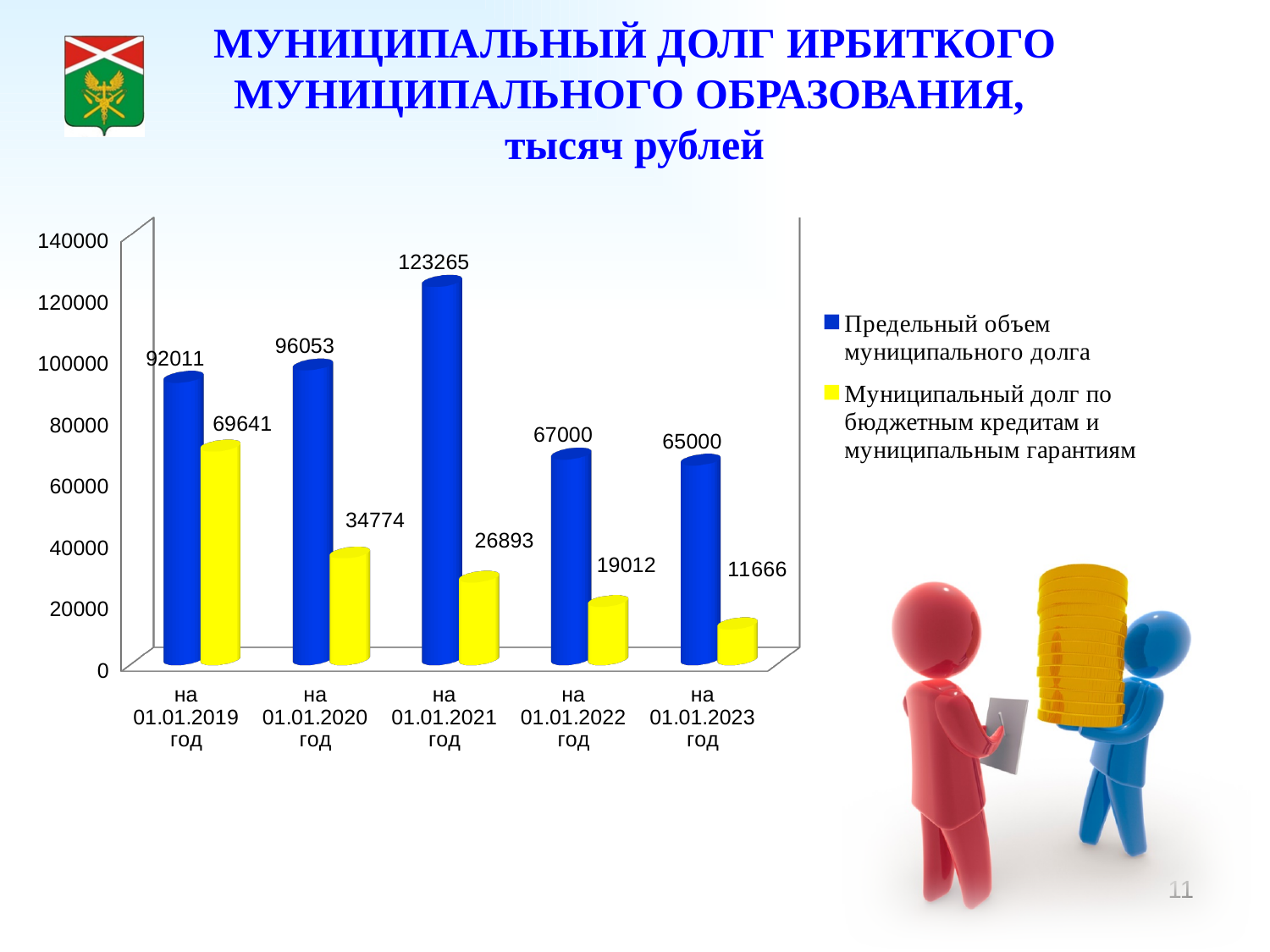
How many dates (categories) are shown on the x axis of the chart? 5 What is the value of «Муниципальный долг по бюджетным кредитам и муниципальным гарантиям» на 01.01.2023 год? 11666 What is the value of «Муниципальный долг по бюджетным кредитам и муниципальным гарантиям» на 01.01.2019 год? 69641 Does «Муниципальный долг по бюджетным кредитам и муниципальным гарантиям» rise or fall from 01.01.2019 to 01.01.2023? fall Which is larger: «Предельный объем муниципального долга» на 01.01.2019 год or на 01.01.2020 год? на 01.01.2020 год What kind of chart is shown on the slide? bar chart What is the value of «Предельный объем муниципального долга» на 01.01.2021 год? 123265 In which year is «Муниципальный долг по бюджетным кредитам и муниципальным гарантиям» the lowest? на 01.01.2023 год In which year is «Предельный объем муниципального долга» the highest? на 01.01.2021 год Is the value of «Муниципальный долг по бюджетным кредитам и муниципальным гарантиям» на 01.01.2020 год greater or less than 40000? less How many series does the legend list? 2 What is the difference between «Предельный объем муниципального долга» and «Муниципальный долг по бюджетным кредитам и муниципальным гарантиям» на 01.01.2022 год? 47988